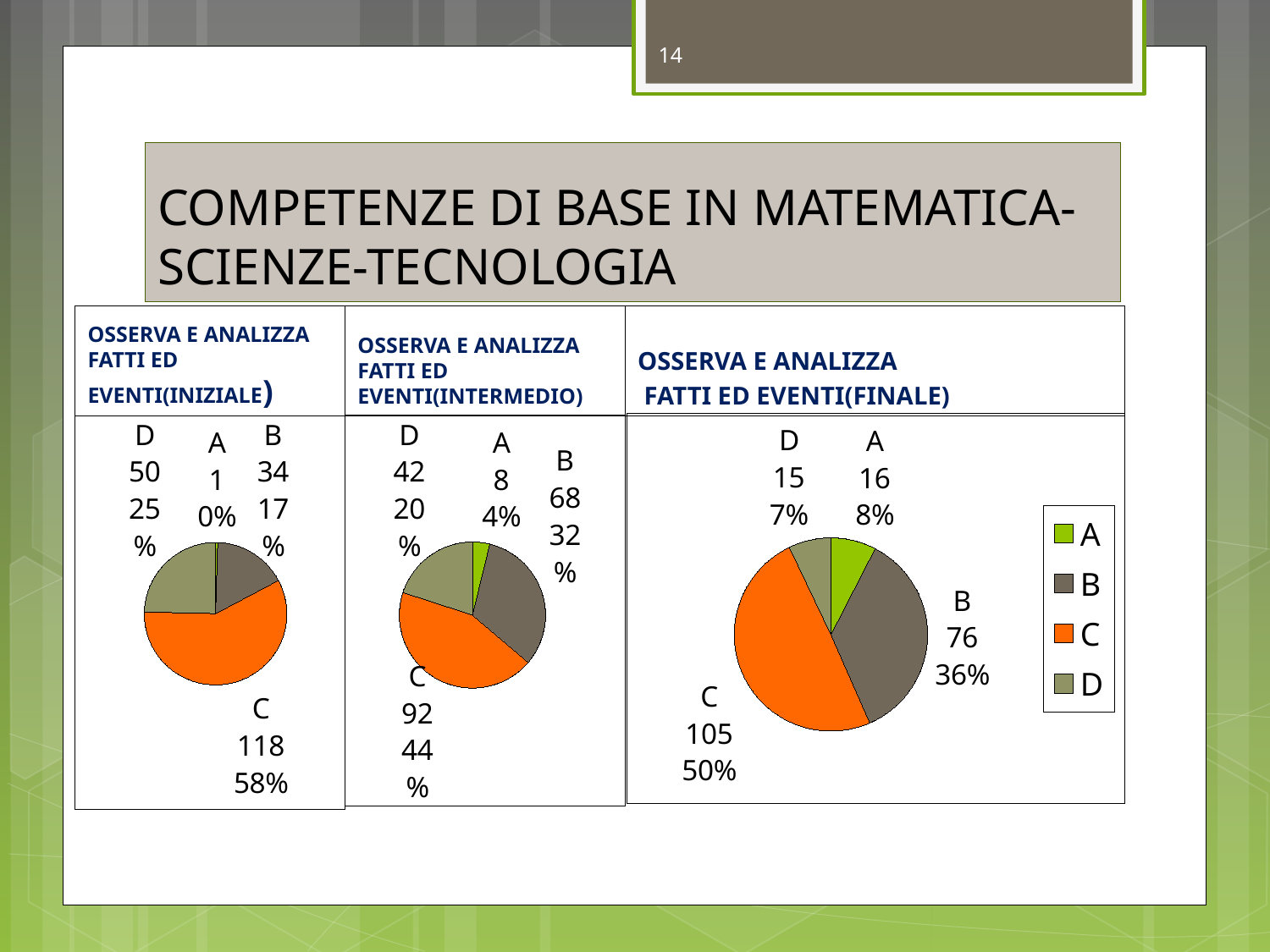
In the OSSERVA E ANALIZZA FATTI ED EVENTI(INIZIALE) chart, what is the value for C? 118 In the OSSERVA E ANALIZZA FATTI ED EVENTI(FINALE) chart, what is the value for A? 16 In the OSSERVA E ANALIZZA FATTI ED EVENTI(INTERMEDIO) chart, what is the value for B? 68 How many entries does the legend of the OSSERVA E ANALIZZA FATTI ED EVENTI(FINALE) chart list? 4 In the OSSERVA E ANALIZZA FATTI ED EVENTI(FINALE) chart, which is larger, the value for D or the value for B? B In the OSSERVA E ANALIZZA FATTI ED EVENTI(FINALE) chart, what percentage share does B have? 36% In the OSSERVA E ANALIZZA FATTI ED EVENTI(INIZIALE) chart, what percentage share does D have? 25% In the OSSERVA E ANALIZZA FATTI ED EVENTI(INTERMEDIO) chart, what is the difference between the values for C and B? 24 What kind of chart is the OSSERVA E ANALIZZA FATTI ED EVENTI(INIZIALE) chart? Pie chart In the OSSERVA E ANALIZZA FATTI ED EVENTI(FINALE) chart, which category has the highest value? C In the OSSERVA E ANALIZZA FATTI ED EVENTI(INTERMEDIO) chart, what percentage share does C have? 44% In the OSSERVA E ANALIZZA FATTI ED EVENTI(INIZIALE) chart, which category has the lowest value? A